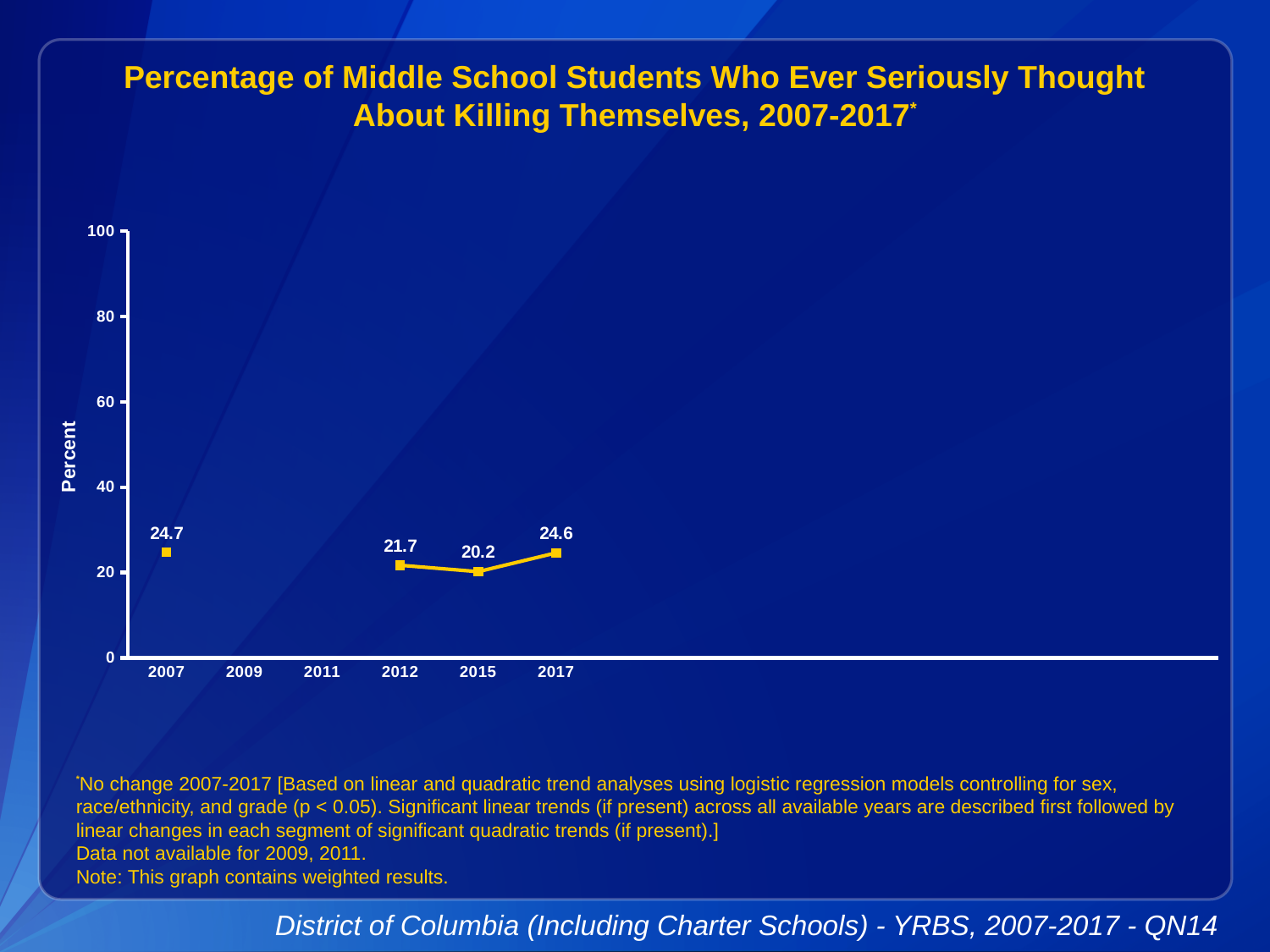
What is the value for 2007? 24.7 Which year has the highest value? 2007 What is the difference between the values for 2017 and 2015? 4.4 What is the label on the y axis? Percent Is the value for 2015 greater or less than 40? less Which year has the lowest value? 2015 How many data points are plotted on the chart? 4 Which is larger, the value for 2012 or the value for 2015? 2012 What is the value for 2015? 20.2 What kind of chart is shown on the slide? line chart What is the value for 2012? 21.7 What is the value for 2017? 24.6